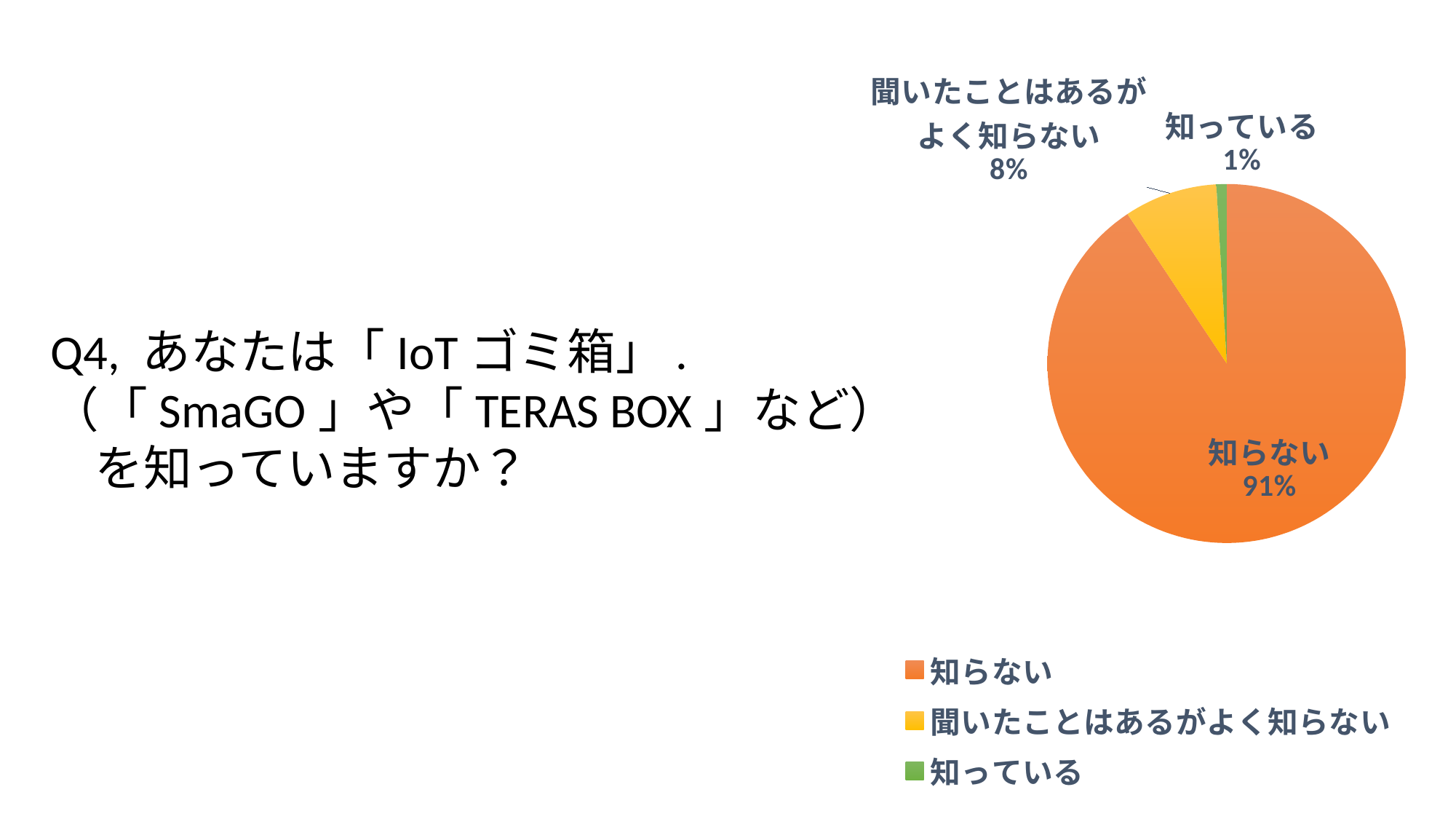
What share of the pie does 知っている have? 1% What share of the pie does 知らない have? 91% What share of the pie does 聞いたことはあるがよく知らない have? 8% What colour is the slice for 知っている? green Which category has the largest slice of the pie? 知らない Which is larger, the slice for 聞いたことはあるがよく知らない or the slice for 知っている? 聞いたことはあるがよく知らない Which category has the smallest slice of the pie? 知っている How many categories does the pie chart have? 3 What kind of chart is shown on the slide? pie chart What is the difference in percentage points between 聞いたことはあるがよく知らない and 知っている? 7 What is the difference in percentage points between 知らない and 聞いたことはあるがよく知らない? 83 How many entries does the legend list? 3